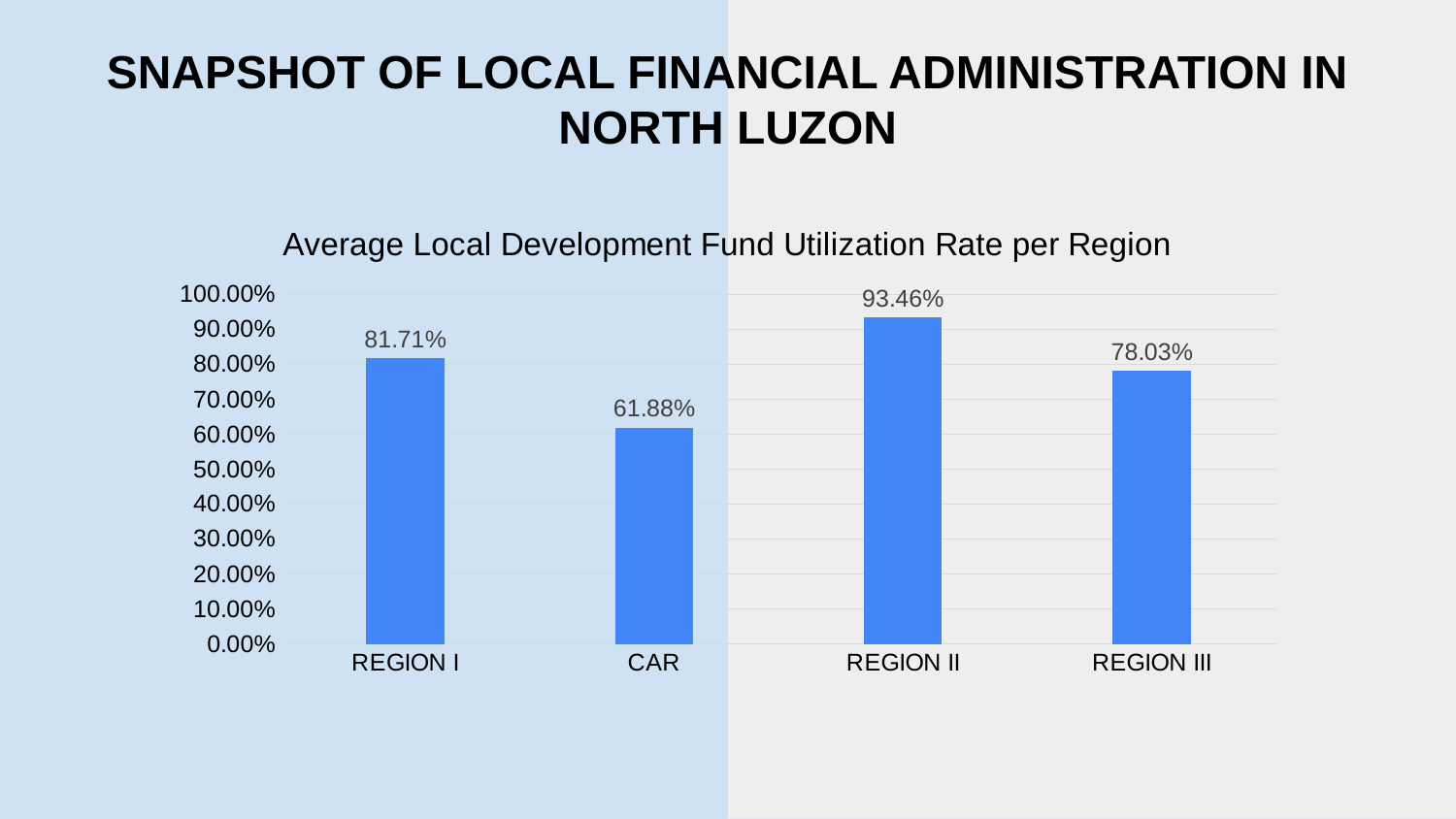
What is the average Local Development Fund utilization rate for REGION I? 81.71% What type of chart is used to show the utilization rates? Bar chart What is the difference between the utilization rates of REGION I and REGION III? 3.68% What is the difference between the utilization rates of REGION II and CAR? 31.58% What is the title of the chart? Average Local Development Fund Utilization Rate per Region Which region has the highest average Local Development Fund utilization rate? REGION II What is the average Local Development Fund utilization rate for REGION II? 93.46% What is the average Local Development Fund utilization rate for CAR? 61.88% What is the average Local Development Fund utilization rate for REGION III? 78.03% Which has a higher utilization rate, REGION I or REGION III? REGION I How many regions are shown in the chart? 4 Which region has the lowest average Local Development Fund utilization rate? CAR